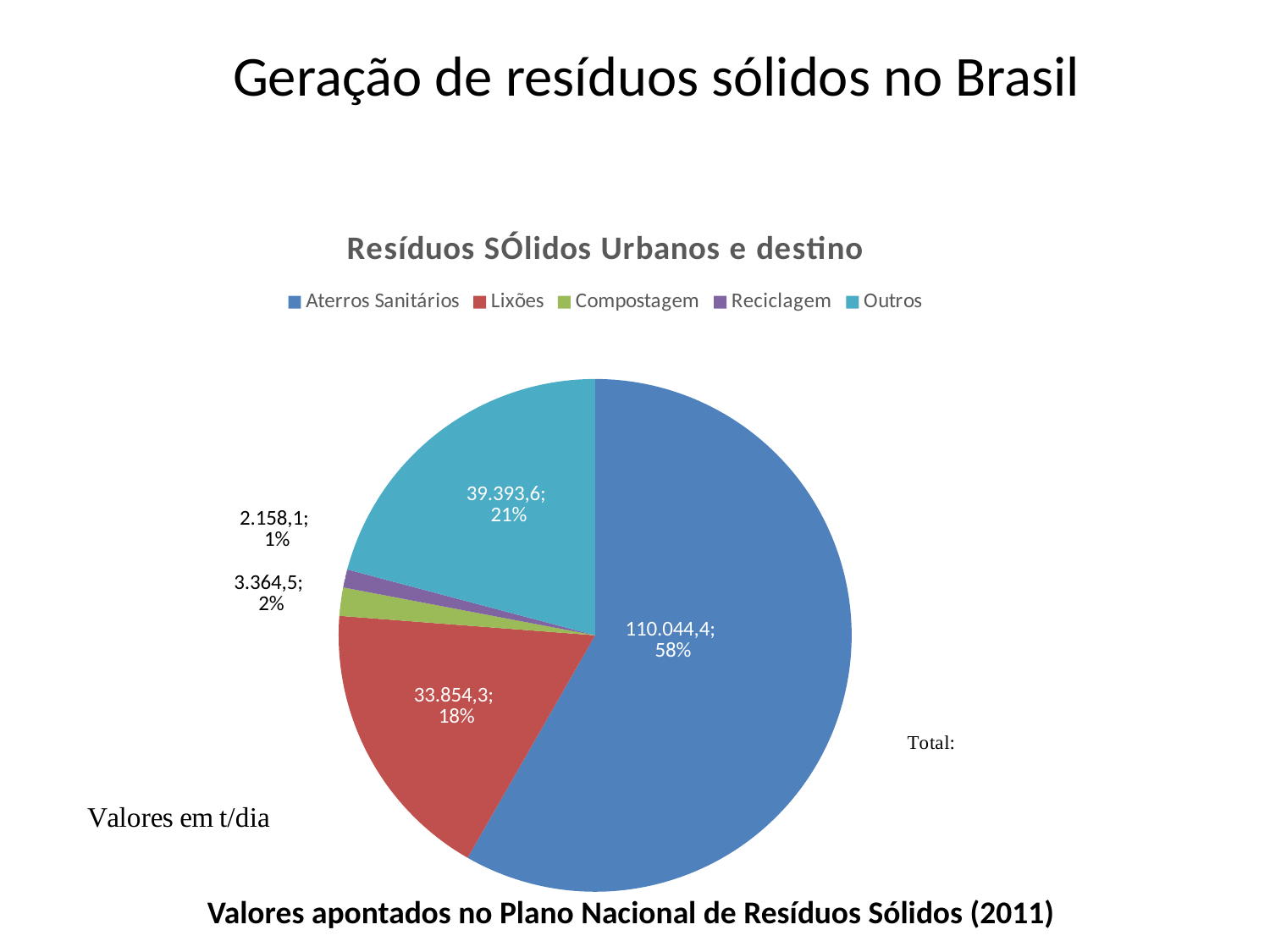
What value is shown for Lixões? 33.854,3 Which category has the smallest slice of the pie? Reciclagem What share of the pie does Reciclagem represent? 1% What share of the pie does Outros represent? 21% How many categories does the legend of the pie chart list? 5 Which is larger, the value for Outros or the value for Lixões? Outros What value is shown for Aterros Sanitários? 110.044,4 What share of the pie does Aterros Sanitários represent? 58% What is the title of the chart? Resíduos SÓlidos Urbanos e destino Which category has the largest slice of the pie? Aterros Sanitários What kind of chart is shown on the slide? pie chart What value is shown for Outros? 39.393,6